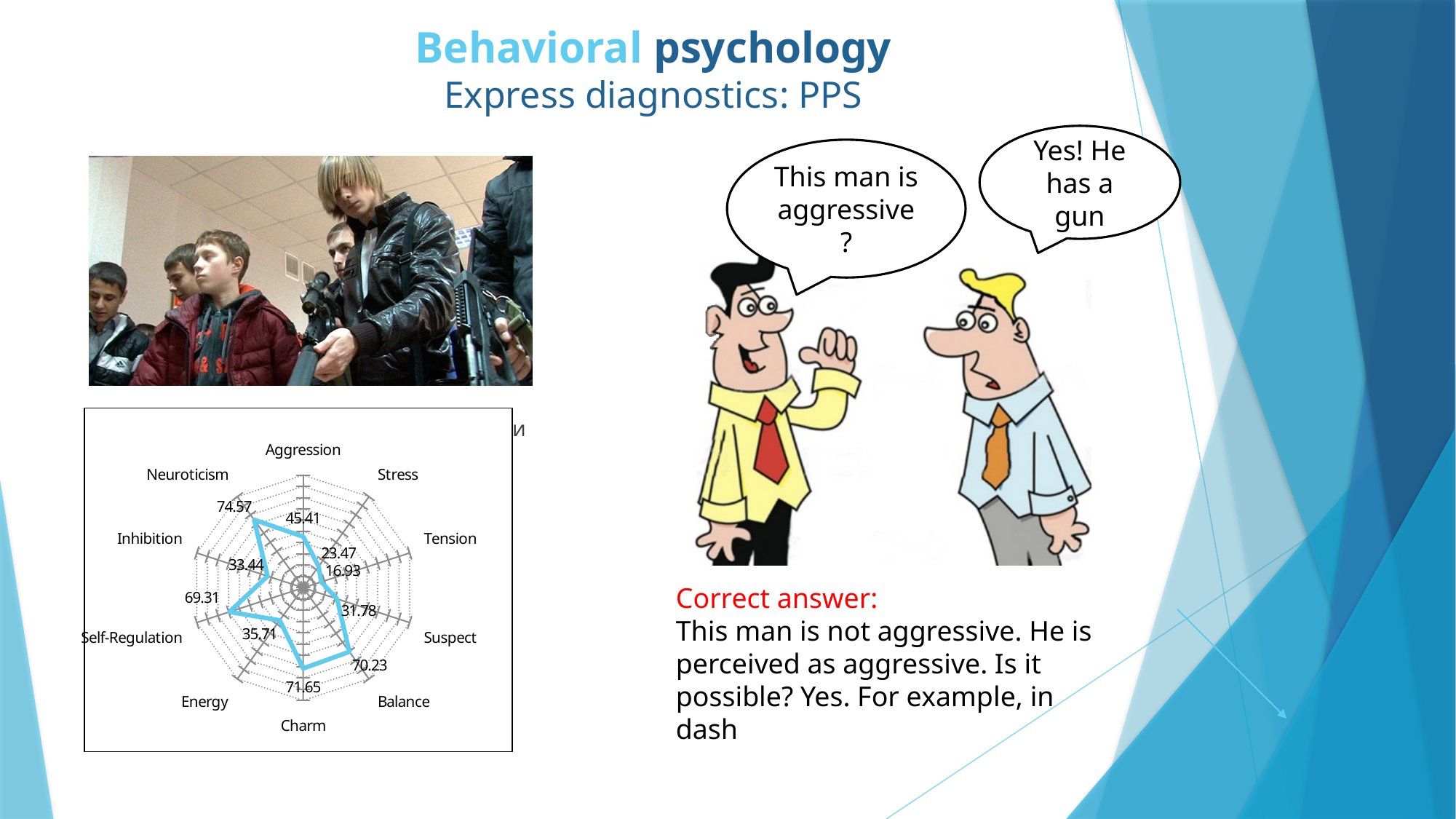
What is the difference between the values for Neuroticism and Tension? 57.64 What is the value for Self-Regulation on the radar chart? 69.31 What is the value for Aggression on the radar chart? 45.41 Which has a larger value, Balance or Energy? Balance What is the value for Neuroticism on the radar chart? 74.57 What is the difference between the values for Aggression and Stress? 21.94 What is the value for Charm on the radar chart? 71.65 What type of chart is shown on the slide? Radar chart What is the value for Tension on the radar chart? 16.93 How many categories are plotted on the radar chart? 10 Which category has the highest value on the radar chart? Neuroticism Which category has the lowest value on the radar chart? Tension